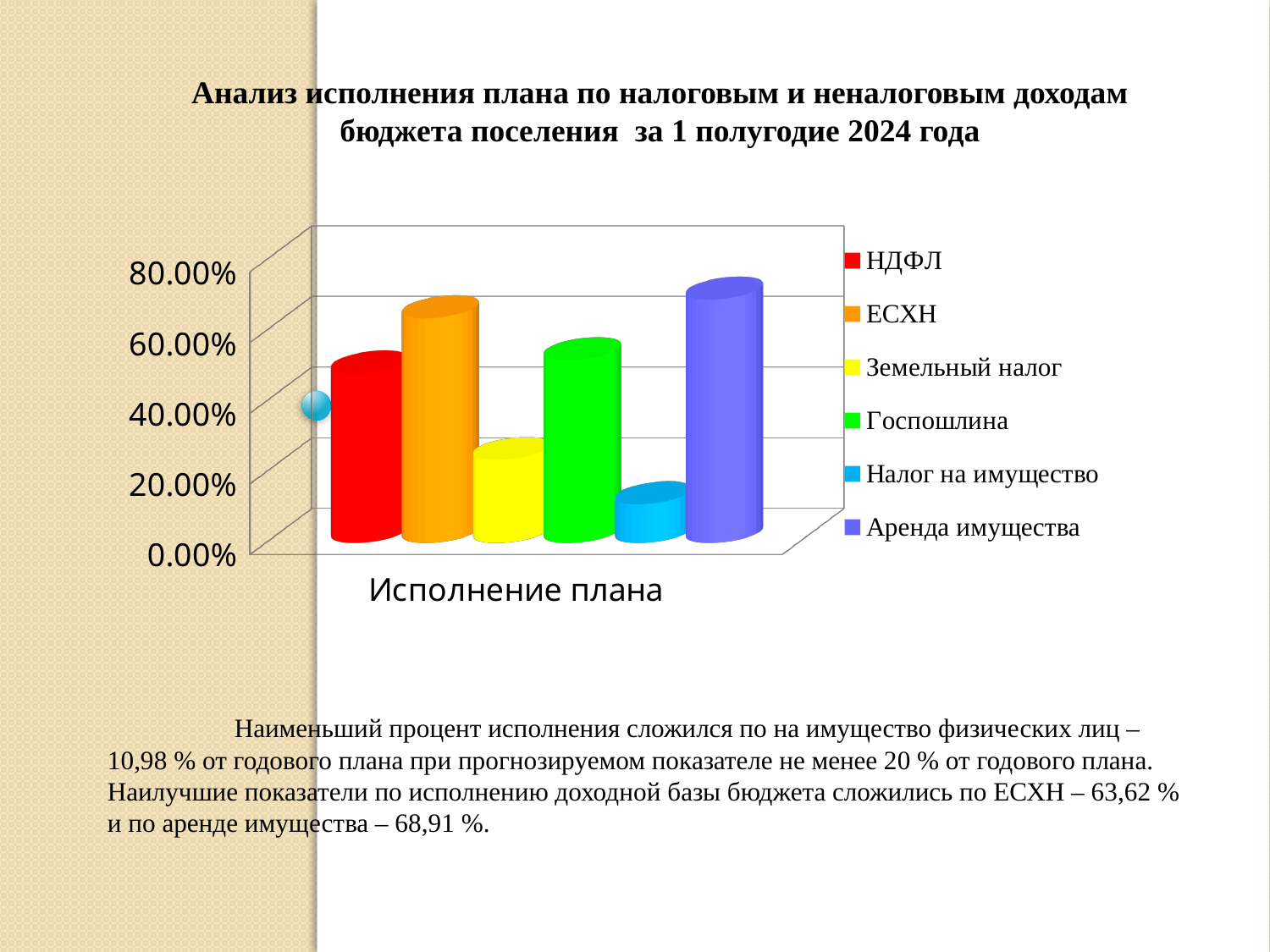
Is the value for Земельный налог greater or less than 40.00%? less Is the value for Аренда имущества greater or less than 60.00%? greater Is the value for НДФЛ greater or less than 40.00%? greater Which series has the lowest value in the chart? Налог на имущество What is the label shown under the bars on the category axis? Исполнение плана Which is larger, the value for Госпошлина or the value for Земельный налог? Госпошлина Which series has the highest value in the chart? Аренда имущества Which is larger, the value for ЕСХН or the value for НДФЛ? ЕСХН How many series does the chart legend list? 6 What kind of chart is shown on the slide? bar chart Which series is drawn in green in the chart? Госпошлина